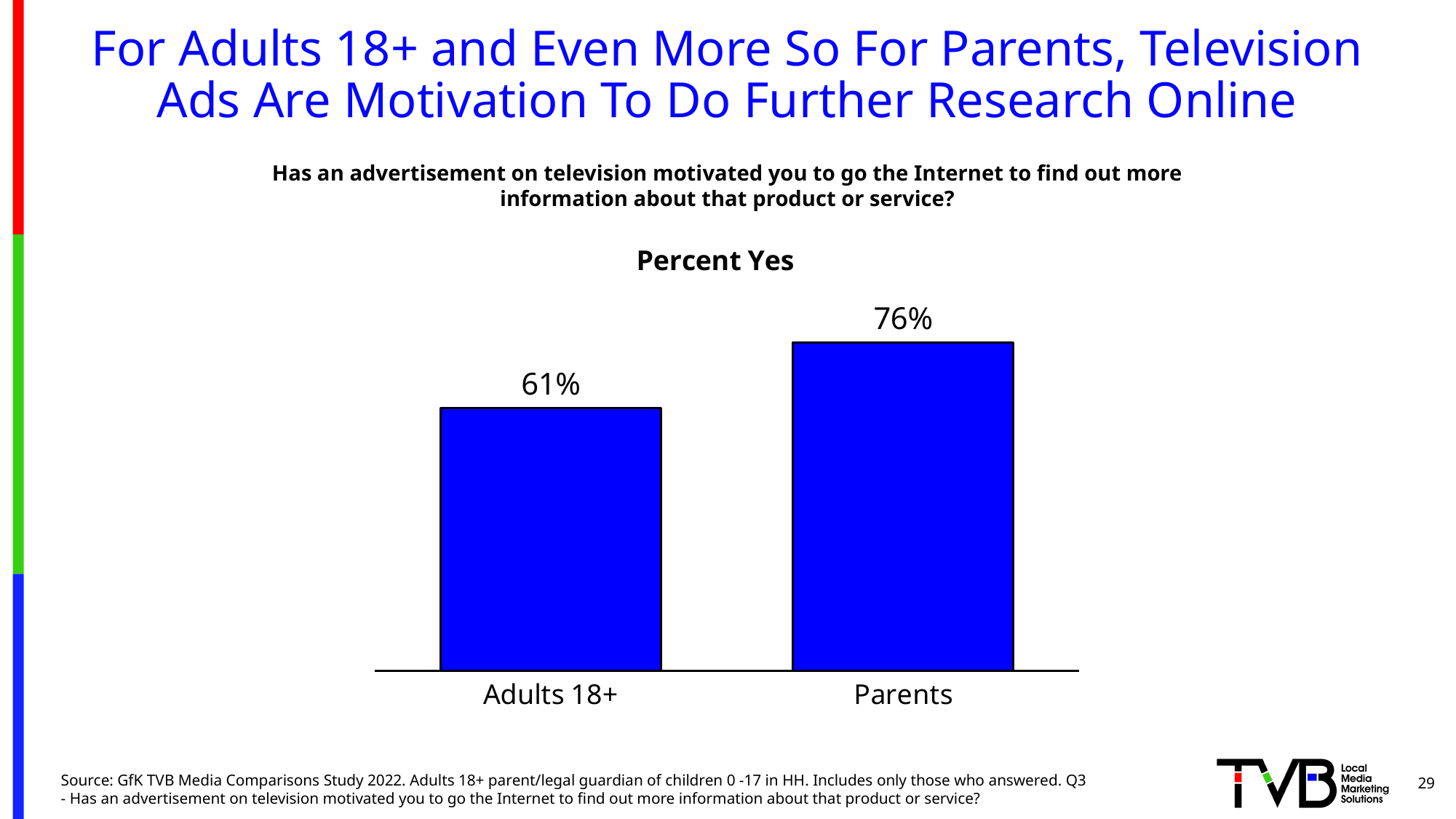
What colour are the bars in the chart? Blue What is the Percent Yes value for Parents? 76% What is the difference in Percent Yes between Parents and Adults 18+? 15% What is the title of the chart? Percent Yes What is the Percent Yes value for Adults 18+? 61% Which is larger, the Percent Yes for Adults 18+ or for Parents? Parents Which category has the lowest Percent Yes value? Adults 18+ What kind of chart is shown on the slide? Bar chart How many categories are shown in the chart? 2 Which category has the highest Percent Yes value? Parents